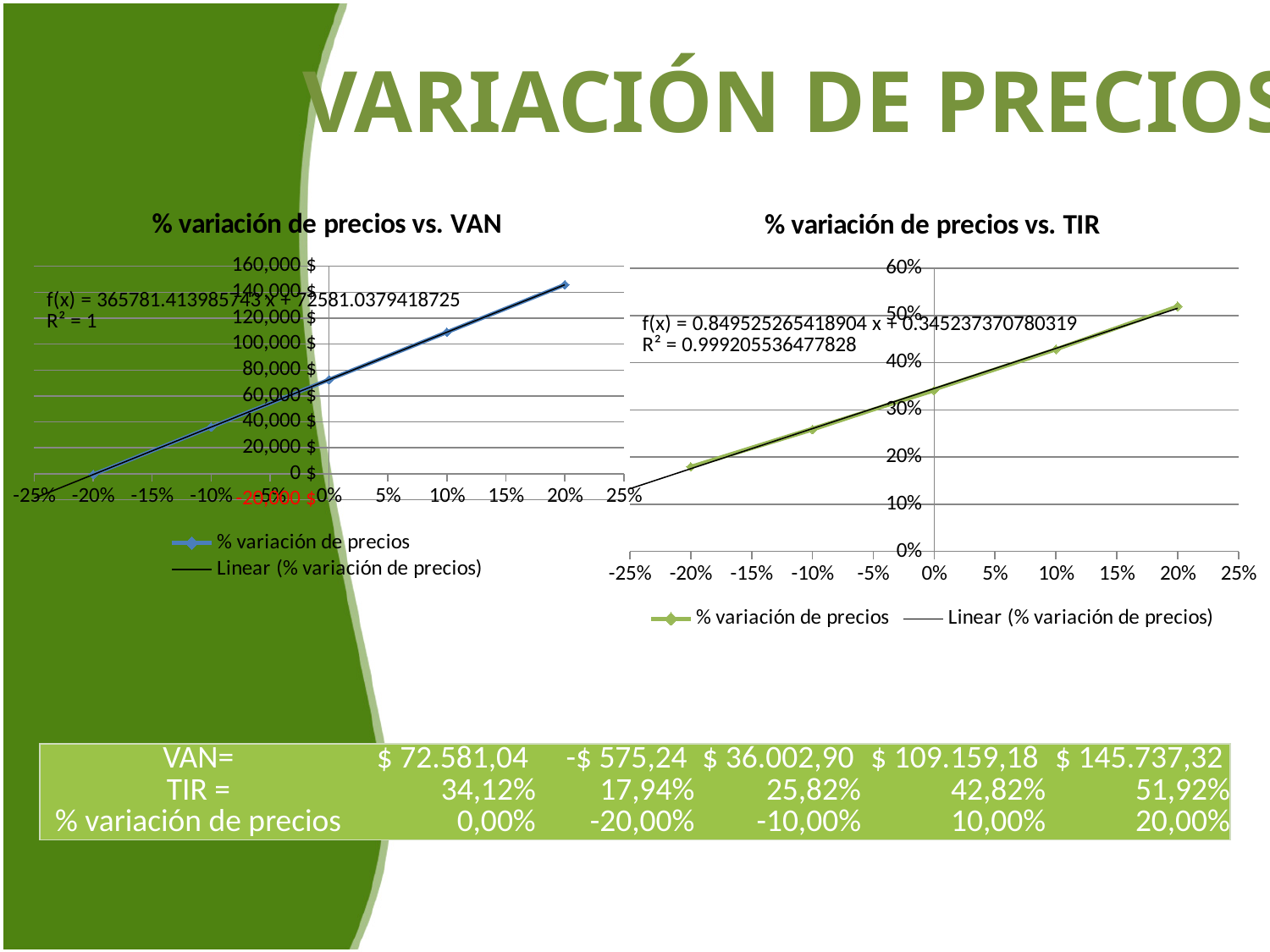
In the '% variación de precios vs. VAN' chart, do the VAN values rise or fall as the % variación de precios increases? rise In the '% variación de precios vs. TIR' chart, is the value at 10% greater or less than 40%? greater What R² value is displayed on the '% variación de precios vs. VAN' chart? R² = 1 In the '% variación de precios vs. VAN' chart, is the value at 10% greater or less than 100,000 $? greater What R² value is displayed on the '% variación de precios vs. TIR' chart? R² = 0.999205536477828 In the '% variación de precios vs. TIR' chart, do the values rise or fall as the % variación de precios increases along the x axis? rise How many data points are plotted in the '% variación de precios vs. TIR' chart? 5 How many entries does the legend of the '% variación de precios vs. VAN' chart list? 2 In the '% variación de precios vs. VAN' chart, is the value at 0% greater or less than 60,000 $? greater In the '% variación de precios vs. VAN' chart, what kind of chart is shown? scatter chart with a linear trendline